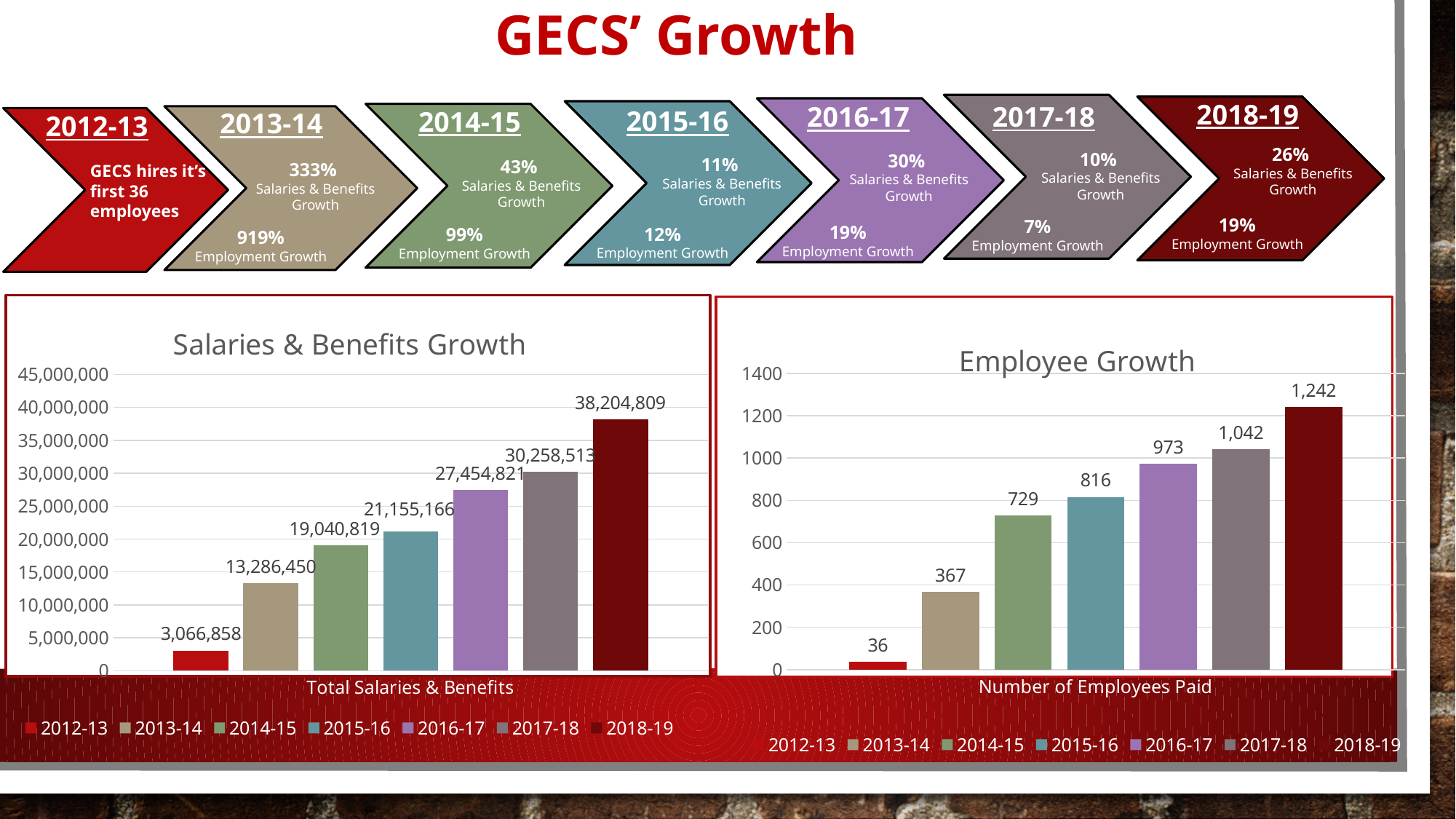
How many entries does the legend of the Salaries & Benefits Growth chart list? 7 In the Salaries & Benefits Growth chart, do the values rise or fall from 2012-13 to 2018-19? rise In the Employee Growth chart, what is the value for 2016-17? 973 In the Salaries & Benefits Growth chart, which year has the highest value? 2018-19 How many bars are plotted in the Employee Growth chart? 7 In the Employee Growth chart, what is the difference between the 2018-19 and 2017-18 values? 200 In the Salaries & Benefits Growth chart, what is the value for 2015-16? 21,155,166 What kind of chart is the Employee Growth chart? bar chart In the Salaries & Benefits Growth chart, is the value for 2017-18 greater or less than 25,000,000? greater In the Employee Growth chart, which year has the lowest value? 2012-13 In the Salaries & Benefits Growth chart, what is the difference between the 2013-14 and 2012-13 values? 10,219,592 In the Employee Growth chart, which is larger: the value for 2014-15 or the value for 2015-16? 2015-16